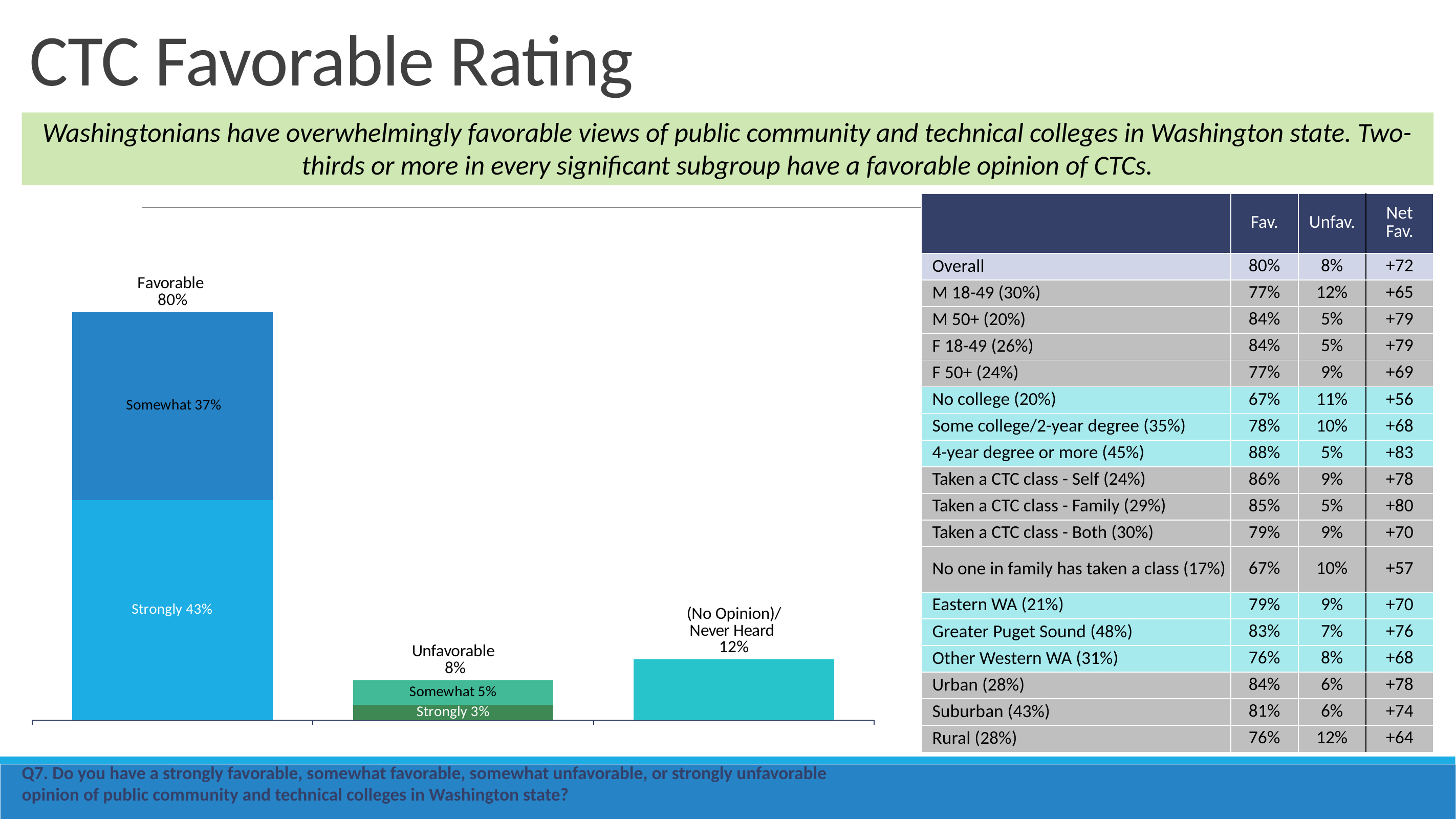
Which category has the lowest total value? Unfavorable What is the Somewhat segment value within the Favorable bar? 37% What is the total value of the Unfavorable bar? 8% Which category has the highest total value? Favorable How many categories are plotted in the bar chart? 3 What is the value for (No Opinion)/Never Heard? 12% What is the difference between the Favorable total and the (No Opinion)/Never Heard value? 68% What kind of chart is shown on the slide? bar chart What is the Strongly segment value within the Favorable bar? 43% What is the Strongly segment value within the Unfavorable bar? 3% What is the Somewhat segment value within the Unfavorable bar? 5% What is the total value of the Favorable bar? 80%